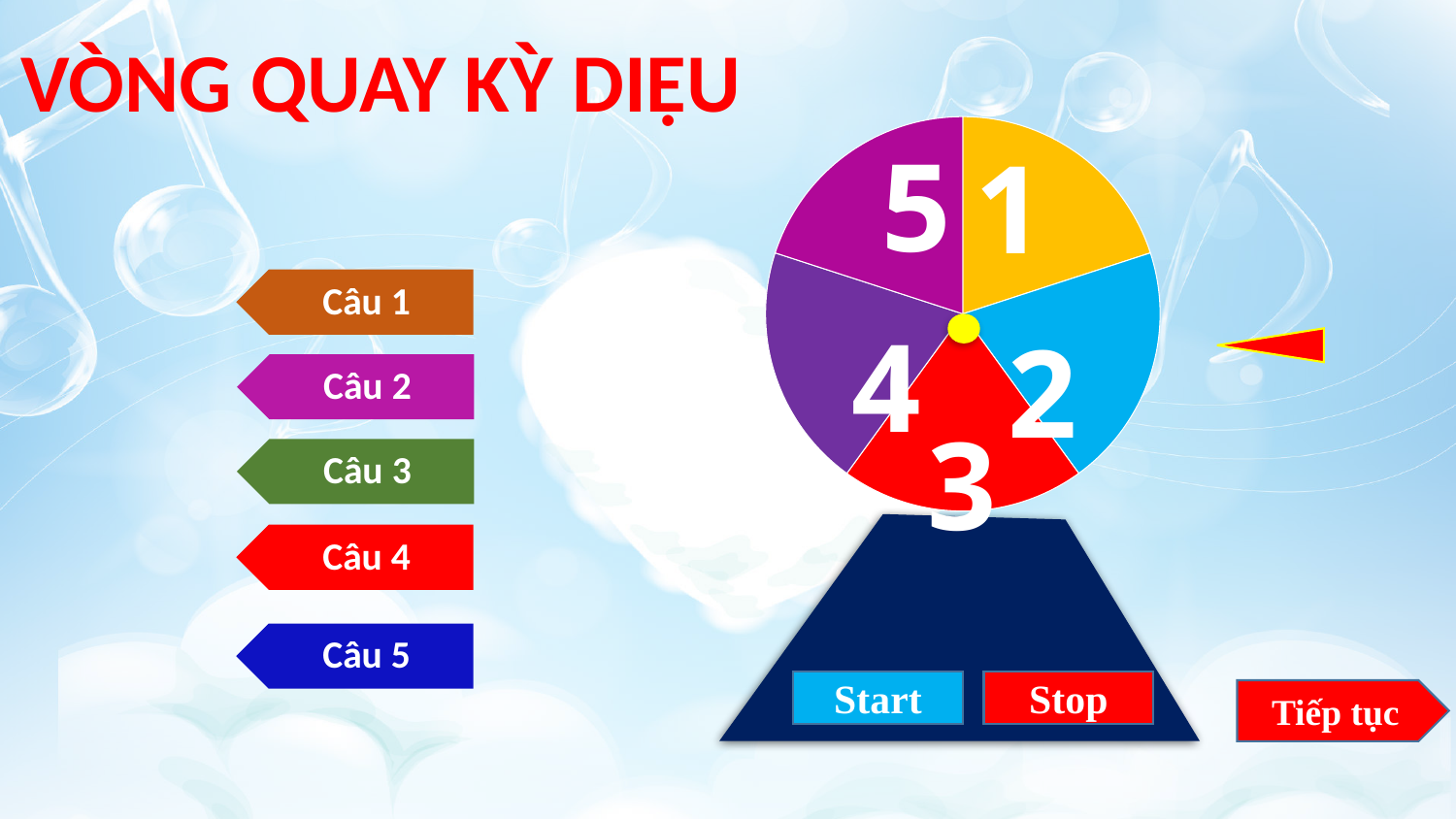
What number is written on the magenta segment of the wheel? 5 What number is written on the light blue segment of the wheel? 2 What number is written on the purple segment of the wheel? 4 What is the title shown at the top of the slide? VÒNG QUAY KỲ DIỆU How many segments does the spinning wheel on the slide have? 5 How many question buttons (Câu) are listed on the left of the slide? 5 What number is written on the yellow segment of the wheel? 1 What number is written on the red segment of the wheel? 3